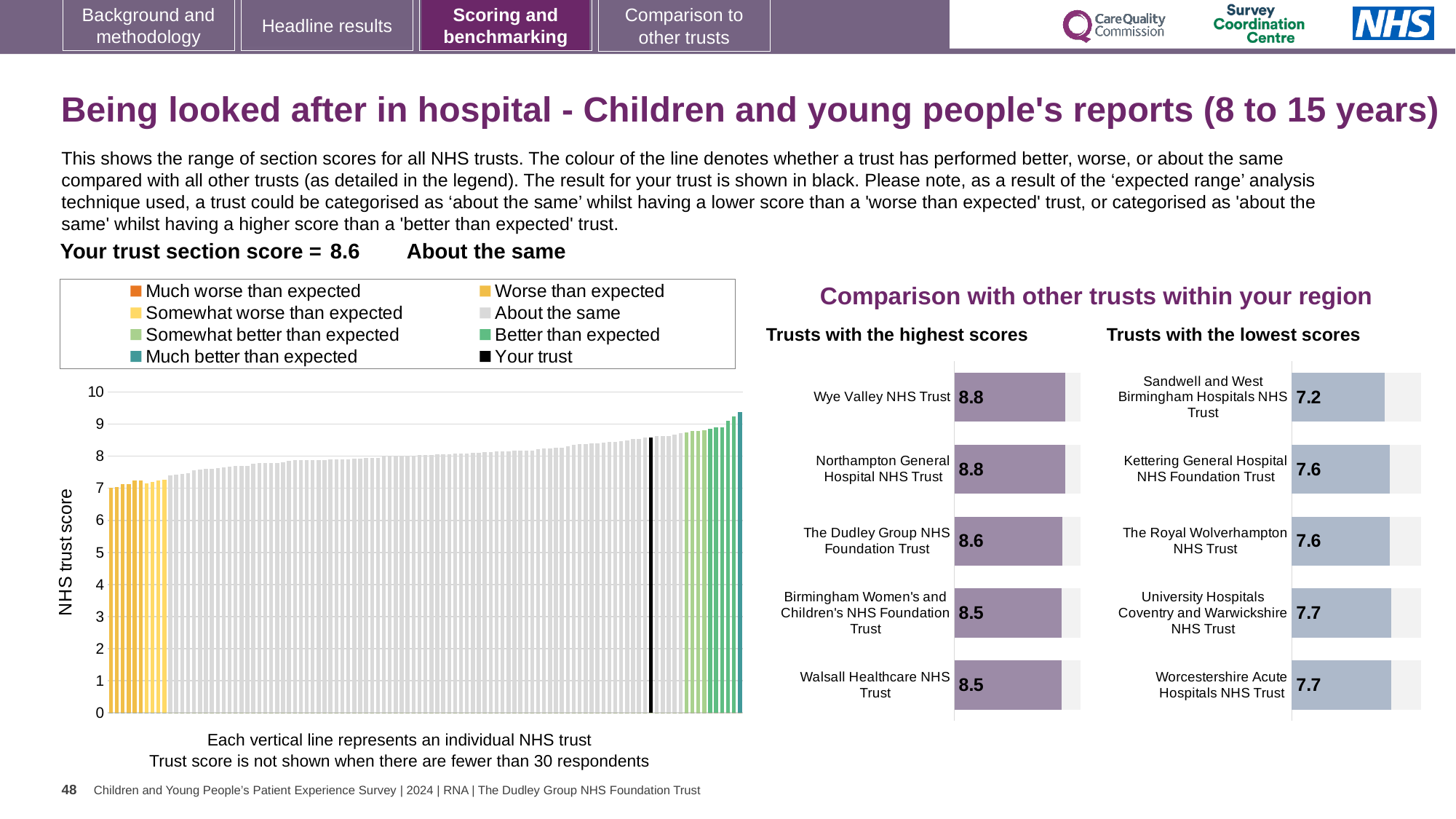
In the 'Trusts with the lowest scores' chart, what is the score for Kettering General Hospital NHS Foundation Trust? 7.6 In the main 'NHS trust score' chart on the left, do the values rise or fall from left to right along the x axis? rise In the 'Trusts with the highest scores' chart, which has the higher score: The Dudley Group NHS Foundation Trust or Birmingham Women's and Children's NHS Foundation Trust? The Dudley Group NHS Foundation Trust In the 'Trusts with the lowest scores' chart, which trust has the lowest score? Sandwell and West Birmingham Hospitals NHS Trust In the 'Trusts with the highest scores' chart, what is the difference between the scores of Wye Valley NHS Trust and Walsall Healthcare NHS Trust? 0.3 In the 'Trusts with the highest scores' chart, what is the score for Wye Valley NHS Trust? 8.8 How many entries does the legend of the main 'NHS trust score' chart list? 8 In the 'Trusts with the highest scores' chart, what is the score for The Dudley Group NHS Foundation Trust? 8.6 What kind of chart is the 'Trusts with the highest scores' chart? bar chart How many trusts are shown in the 'Trusts with the lowest scores' chart? 5 In the main 'NHS trust score' chart on the left, is the value for the black 'Your trust' line greater or less than 8? greater What is the difference between Wye Valley NHS Trust's score in the 'Trusts with the highest scores' chart and Sandwell and West Birmingham Hospitals NHS Trust's score in the 'Trusts with the lowest scores' chart? 1.6